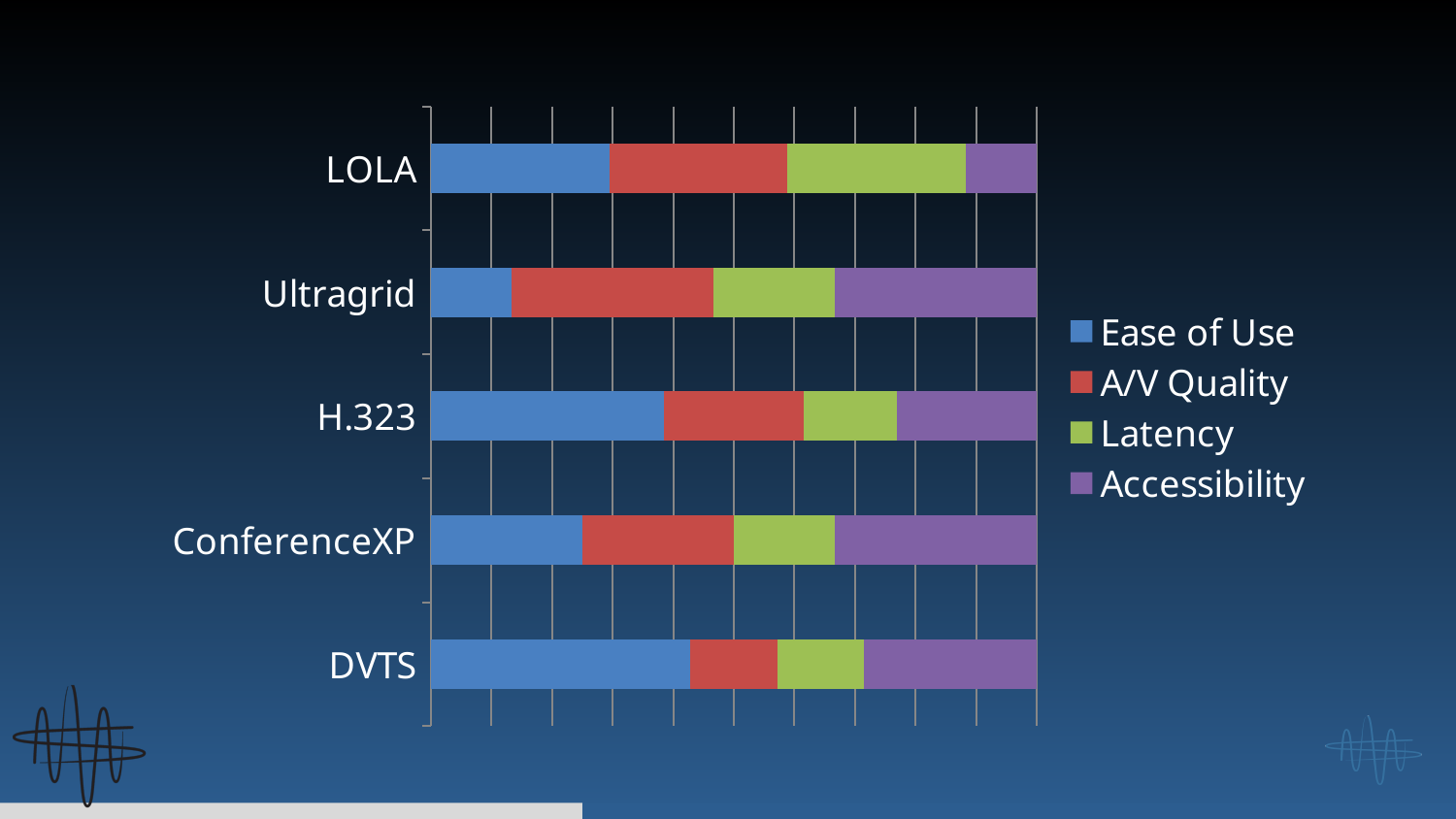
Which category has the largest Ease of Use segment? DVTS How many categories (systems) are plotted on the chart? 5 How many series does the legend list? 4 Which colour represents Latency in the legend? Green Which category has the largest Latency segment? LOLA Which category has the smallest A/V Quality segment? DVTS What kind of chart is shown on the slide? Stacked bar chart Which category has the smallest Accessibility segment? LOLA Is the Ease of Use segment larger for DVTS or for Ultragrid? DVTS Is the A/V Quality segment larger for Ultragrid or for DVTS? Ultragrid Which category has the smallest Ease of Use segment? Ultragrid